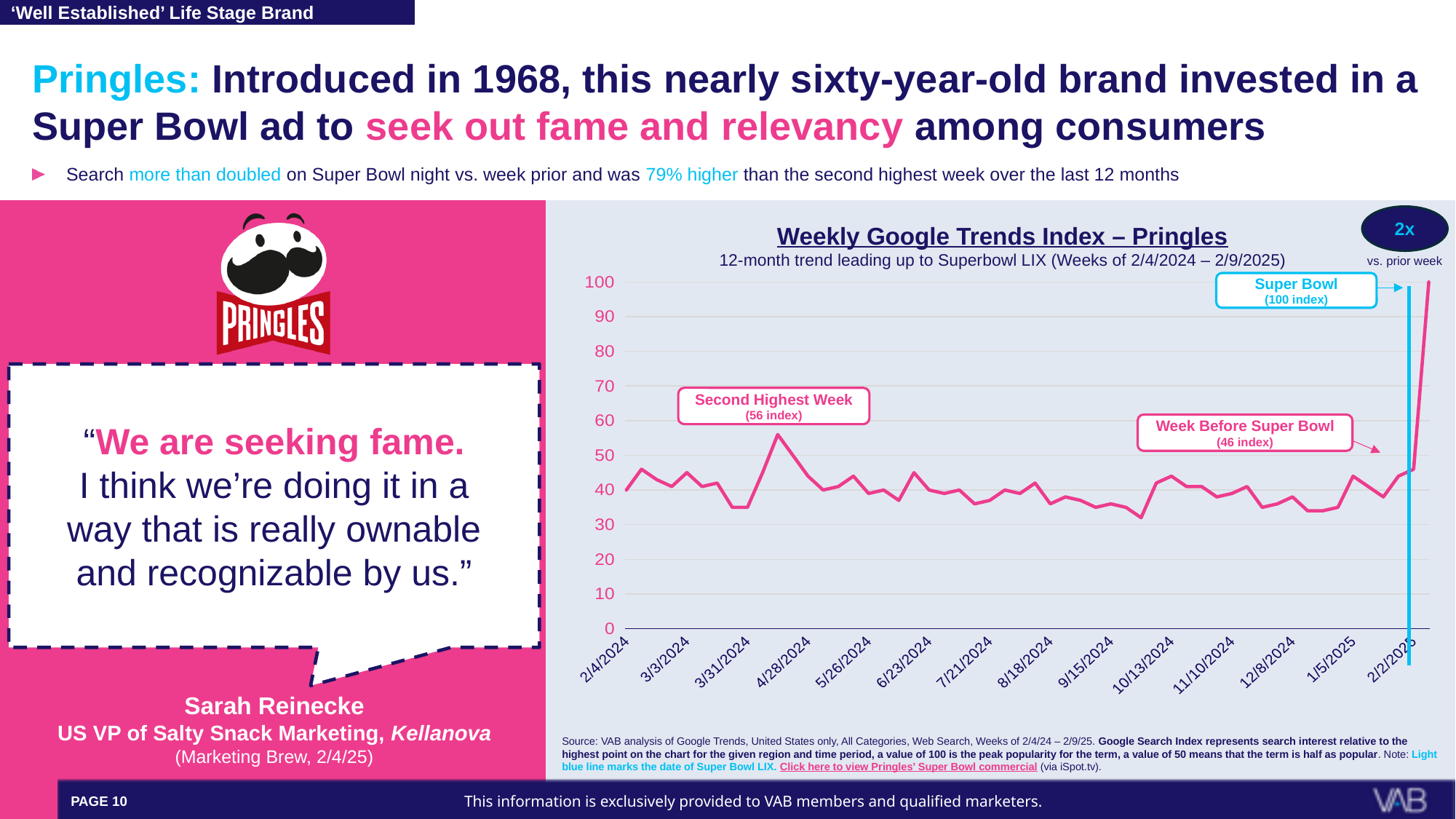
Which is larger, the Super Bowl week index or the Second Highest Week index? Super Bowl week What is the Google Trends index value for the Super Bowl week? 100 What is the index value for the Second Highest Week? 56 What does the light blue vertical line on the chart mark? the date of Super Bowl LIX What is the difference between the Second Highest Week index and the Week Before Super Bowl index? 10 What is the difference between the Super Bowl week index and the Second Highest Week index? 44 How much higher is the Super Bowl week index than the Week Before Super Bowl index? 54 What is the title of the chart? Weekly Google Trends Index – Pringles Which week has the highest index value on the chart? Super Bowl week What kind of chart is shown on the slide? line chart Is the index value for the week of 2/4/2024 greater or less than 50? less What is the index value for the Week Before Super Bowl? 46